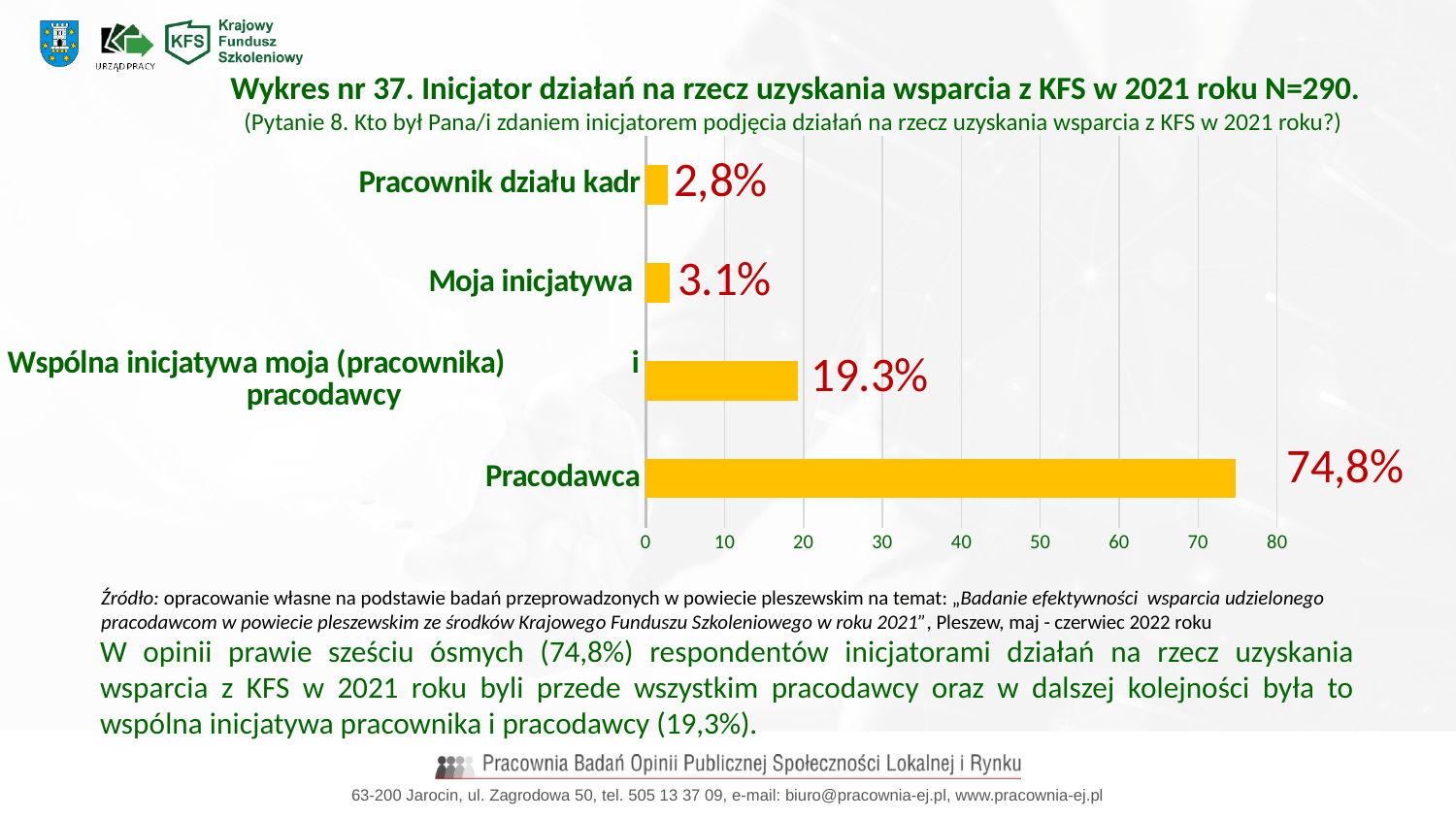
How many categories are shown in the chart? 4 What is the title of the chart? Wykres nr 37. Inicjator działań na rzecz uzyskania wsparcia z KFS w 2021 roku N=290. What is the difference between the values for Wspólna inicjatywa moja (pracownika) i pracodawcy and Moja inicjatywa? 16.2 percentage points Which category has the highest value? Pracodawca Which is larger, the value for Pracodawca or the value for Wspólna inicjatywa moja (pracownika) i pracodawcy? Pracodawca What is the value for Moja inicjatywa? 3.1% What is the value for Wspólna inicjatywa moja (pracownika) i pracodawcy? 19.3% Which category has the lowest value? Pracownik działu kadr What is the value for Pracownik działu kadr? 2,8% What is the value for Pracodawca? 74,8% What kind of chart is shown on the slide? bar chart Is the value for Pracodawca greater or less than 70? greater